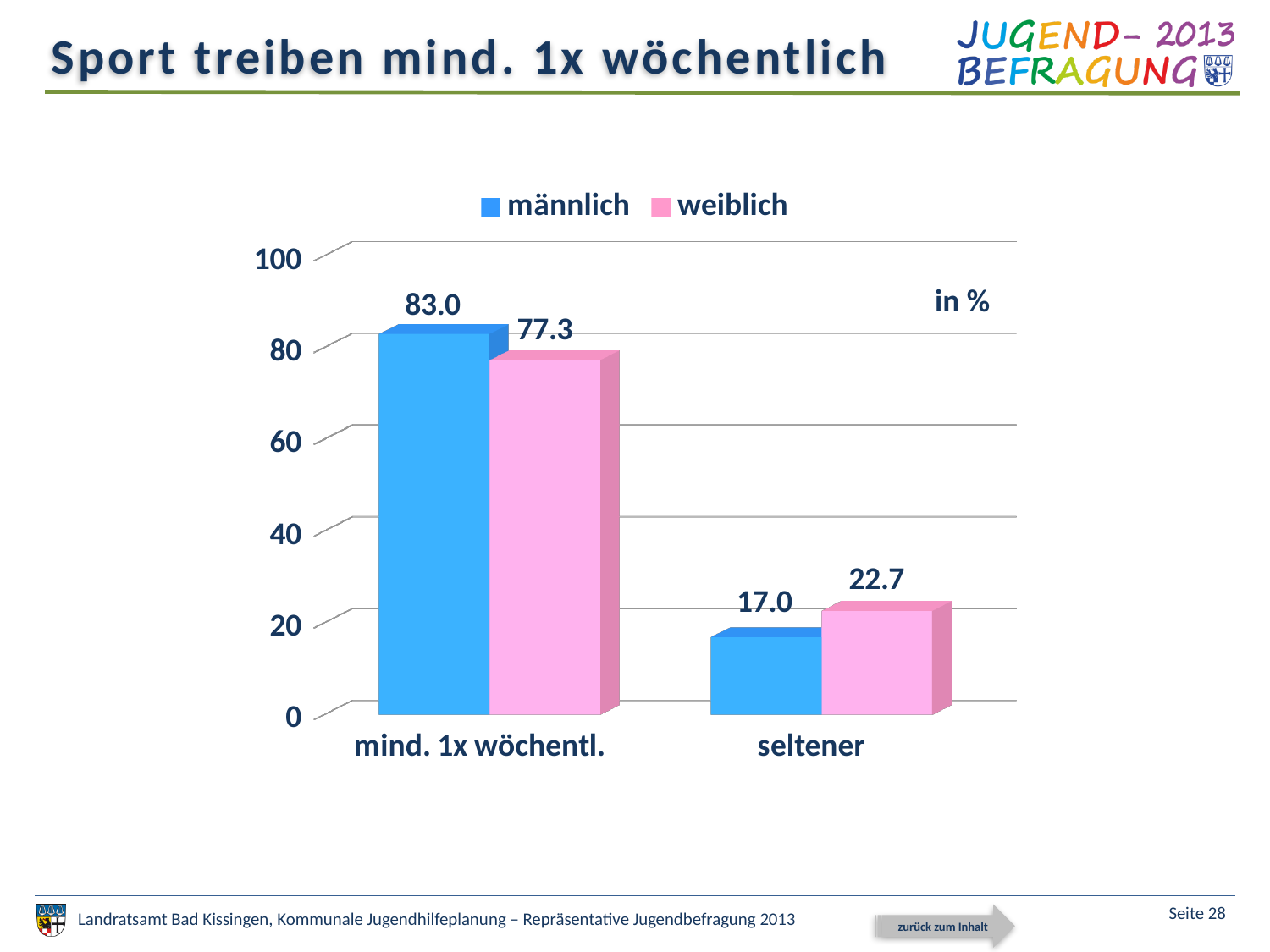
What is the value for männlich in the 'seltener' category? 17.0 How many categories are shown on the x axis? 2 What is the difference between the weiblich and männlich values in the 'seltener' category? 5.7 What is the value for weiblich in the 'mind. 1x wöchentl.' category? 77.3 What is the value for männlich in the 'mind. 1x wöchentl.' category? 83.0 Which series has the higher value in the 'mind. 1x wöchentl.' category? männlich How many series does the legend list? 2 What is the value for weiblich in the 'seltener' category? 22.7 What kind of chart is shown on the slide? Bar chart Which colour represents the weiblich series? Pink Which series has the higher value in the 'seltener' category? weiblich What is the difference between the männlich and weiblich values in the 'mind. 1x wöchentl.' category? 5.7